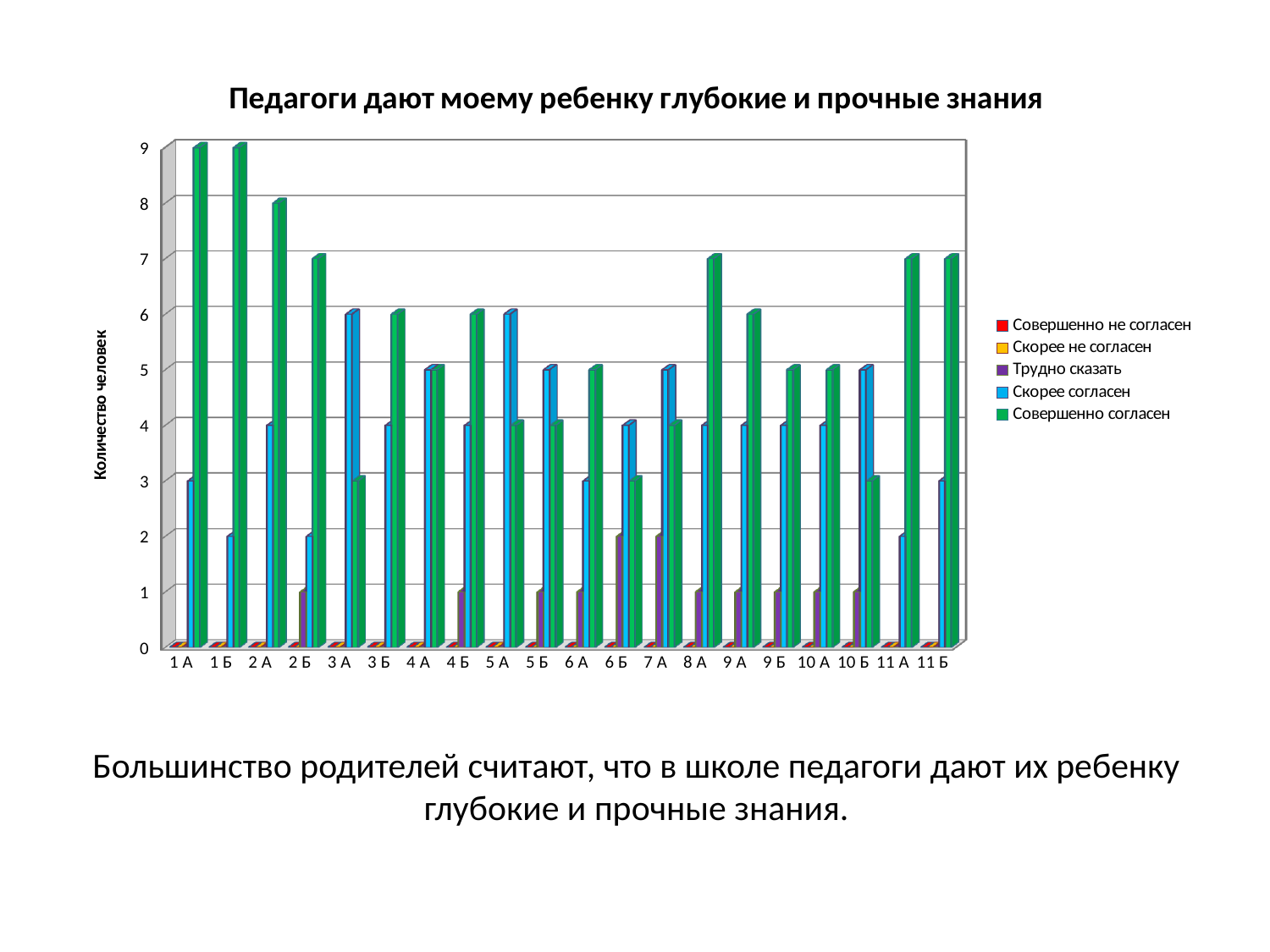
How many classes (categories) are shown on the x axis? 20 Which class has the larger 'Совершенно согласен' value: 1 А or 6 Б? 1 А What is the value of 'Совершенно согласен' for class 2 А? 8 What is the title of the chart? Педагоги дают моему ребенку глубокие и прочные знания What is the label of the vertical axis? Количество человек Is the value of 'Совершенно согласен' for class 1 А greater or less than 8? greater What is the value of 'Скорее согласен' for class 3 А? 6 For class 3 А, which is larger: 'Скорее согласен' or 'Совершенно согласен'? Скорее согласен What is the value of 'Скорее согласен' for class 1 Б? 2 What kind of chart is shown on the slide? bar chart How many series does the legend list? 5 Is the value of 'Совершенно согласен' for class 3 А greater or less than 4? less